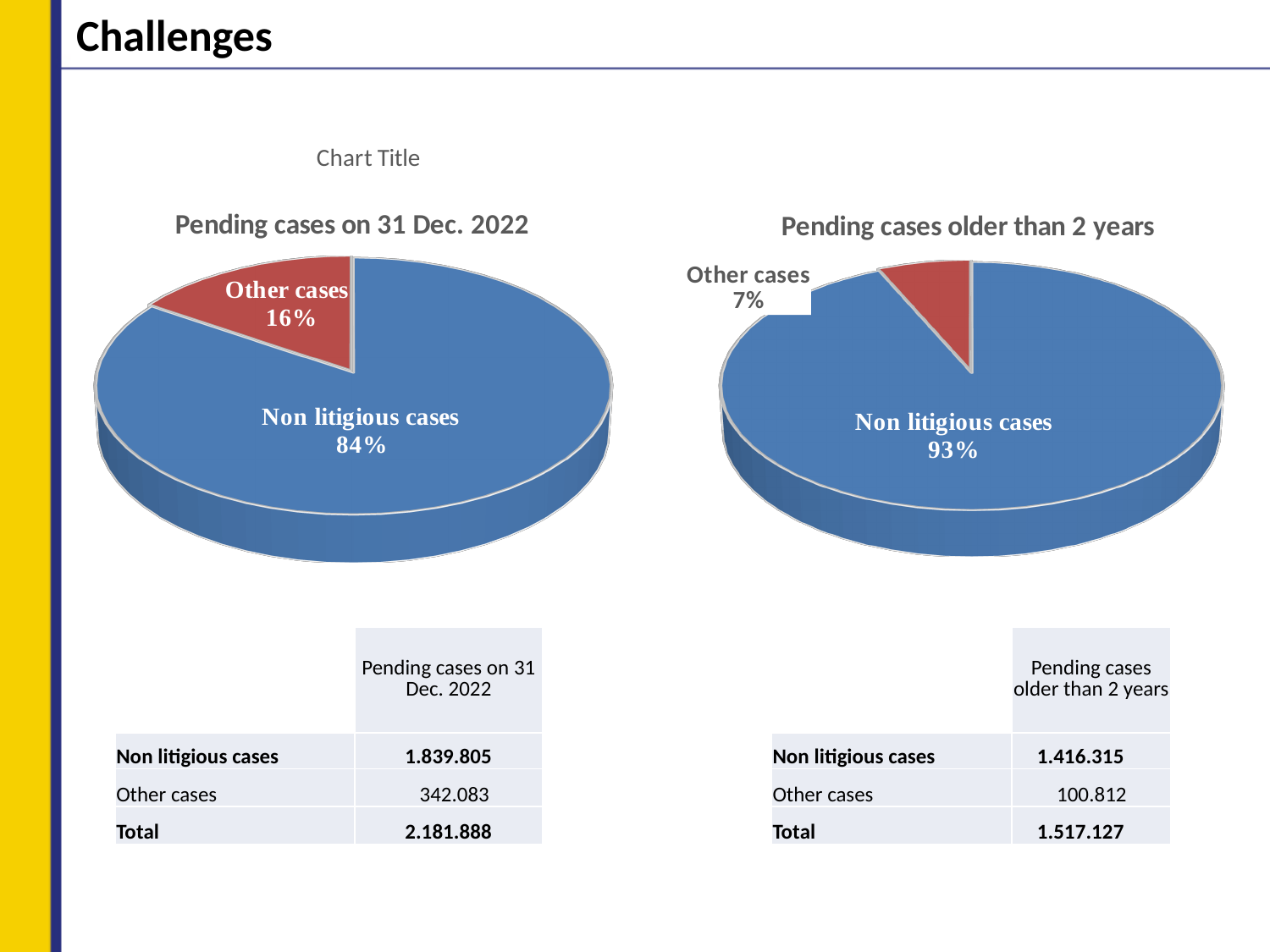
What is the difference in percentage points between the Non litigious cases share in the 'Pending cases older than 2 years' chart and in the 'Pending cases on 31 Dec. 2022' chart? 9 percentage points What kind of chart is the 'Pending cases on 31 Dec. 2022' chart? Pie chart In the 'Pending cases on 31 Dec. 2022' chart, what share of the pie is labelled for Non litigious cases? 84% Comparing the two pie charts, which chart shows the larger share for Other cases? Pending cases on 31 Dec. 2022 How many slices does the 'Pending cases older than 2 years' pie chart have? 2 In the 'Pending cases older than 2 years' chart, what share of the pie is labelled for Other cases? 7% In the 'Pending cases on 31 Dec. 2022' chart, which slice is larger, Other cases or Non litigious cases? Non litigious cases What colour is the Other cases slice in the 'Pending cases older than 2 years' chart? Red In the 'Pending cases on 31 Dec. 2022' chart, which slice is the largest? Non litigious cases In the 'Pending cases older than 2 years' chart, which slice is the smallest? Other cases In the 'Pending cases on 31 Dec. 2022' chart, what share of the pie is labelled for Other cases? 16%